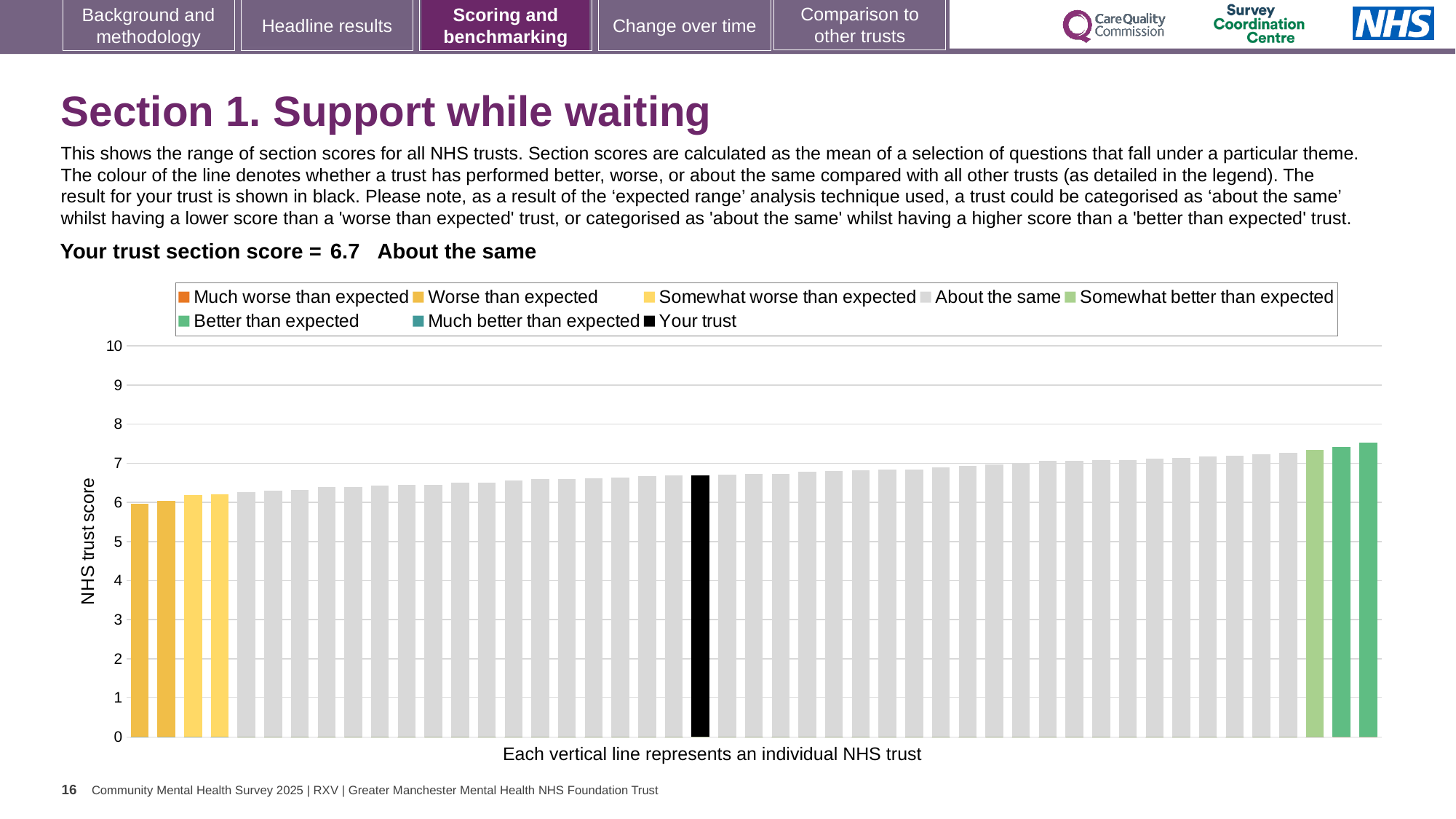
What is the section score for your trust shown on the slide? 6.7 Is the value of the leftmost bar greater or less than 5? greater Is the value of the tallest bar on the right of the chart greater or less than 7? greater Is the value of the black 'Your trust' bar greater or less than 7? less What is the label on the vertical axis of the chart? NHS trust score How many entries does the chart legend list? 8 Which category is your trust's section score placed in? About the same Do the bar values rise or fall from left to right along the x axis? rise What kind of chart is shown on the slide? bar chart What colour is the bar representing your trust? black